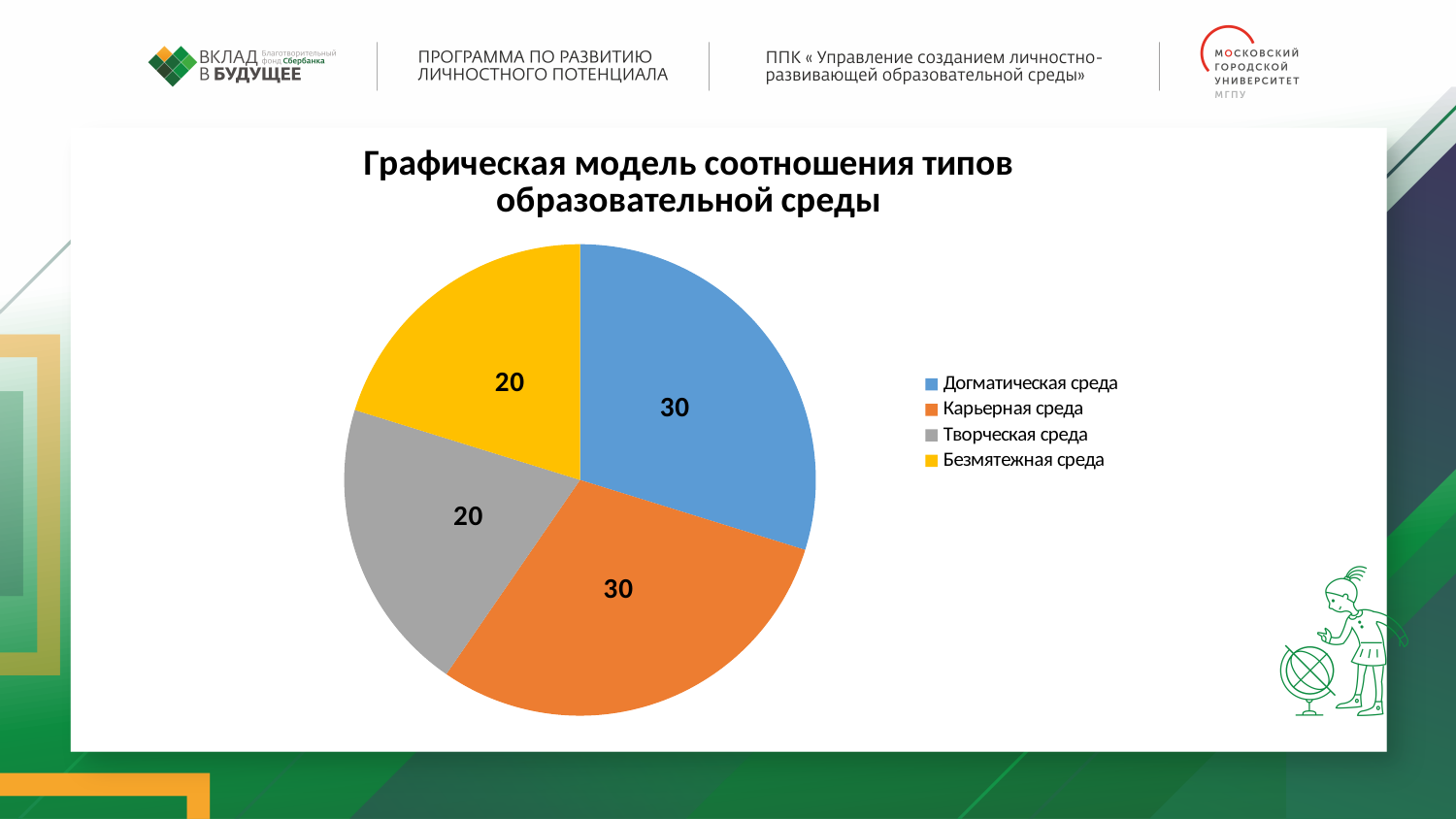
What colour is the slice for Безмятежная среда? yellow What is the value for Безмятежная среда? 20 How many entries does the legend list? 4 What share of the pie does Догматическая среда represent? 30% What kind of chart is shown on the slide? pie chart What share of the pie does Творческая среда represent? 20% Which is larger, the value for Догматическая среда or the value for Творческая среда? Догматическая среда What is the value for Догматическая среда? 30 What is the difference between the values for Карьерная среда and Безмятежная среда? 10 What is the value for Карьерная среда? 30 What is the value for Творческая среда? 20 How many slices does the pie chart have? 4